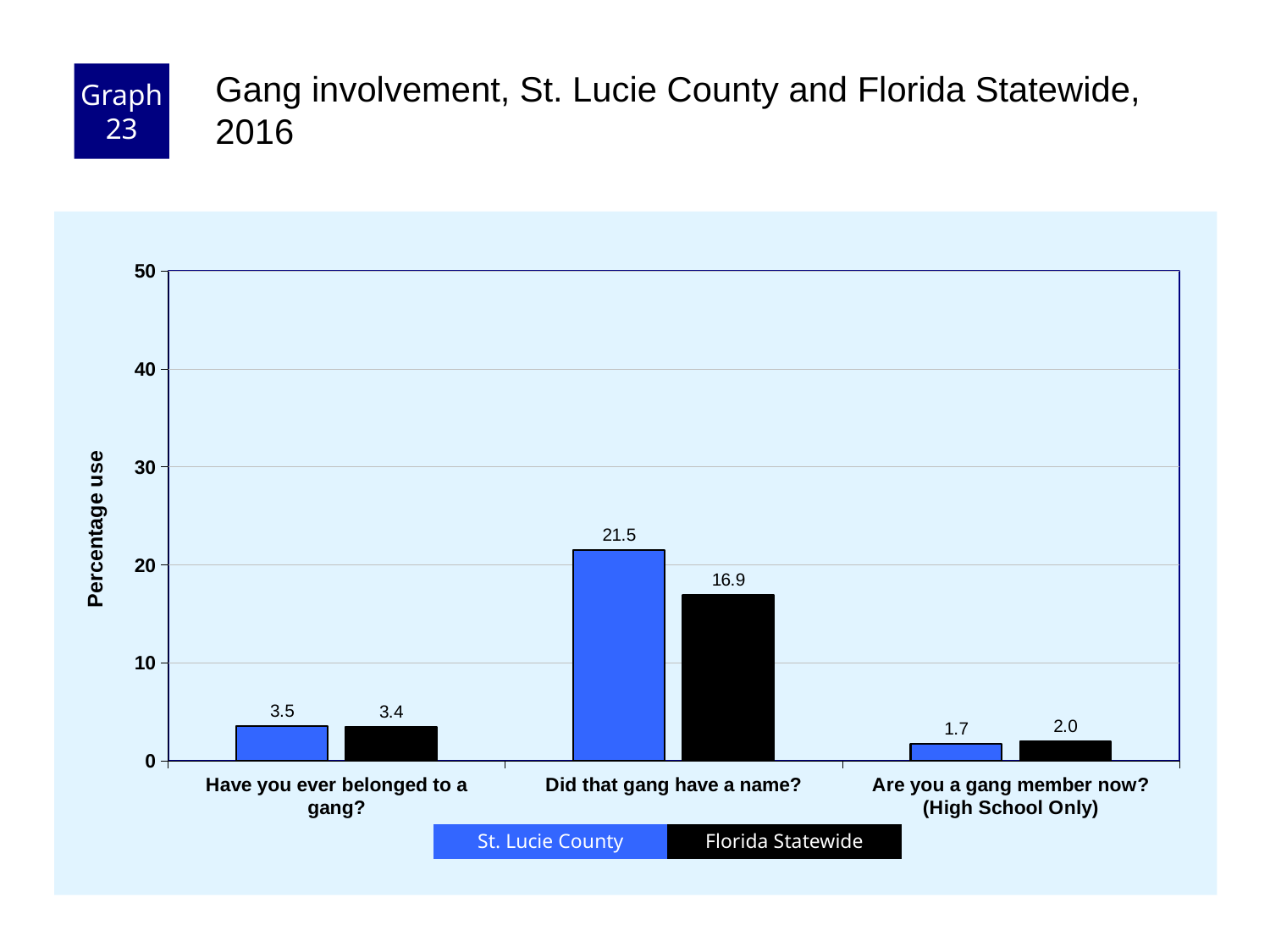
What is the Florida Statewide value for "Have you ever belonged to a gang?"? 3.4 What is the difference between the St. Lucie County and Florida Statewide values for "Did that gang have a name?"? 4.6 How many series does the legend list? 2 For "Are you a gang member now? (High School Only)", which is larger: St. Lucie County or Florida Statewide? Florida Statewide What is the St. Lucie County value for "Did that gang have a name?"? 21.5 What kind of chart is shown on the slide? Bar chart Which question has the lowest Florida Statewide value? Are you a gang member now? (High School Only) Is the St. Lucie County value for "Did that gang have a name?" greater or less than 20? greater How many question categories are shown on the x axis? 3 Which question has the highest St. Lucie County value? Did that gang have a name? What is the Florida Statewide value for "Are you a gang member now? (High School Only)"? 2.0 What is the label of the y axis? Percentage use